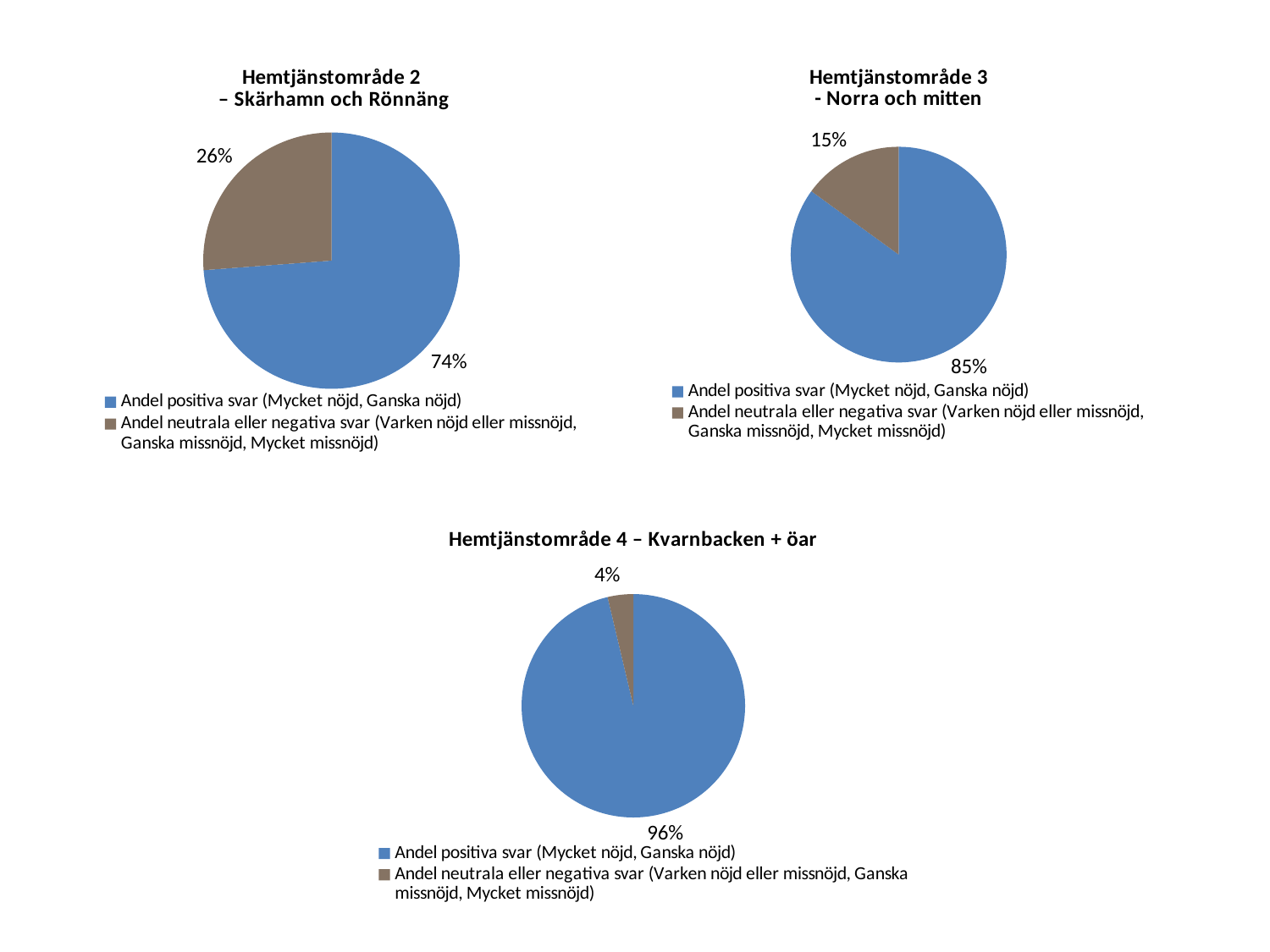
In the 'Hemtjänstområde 4 – Kvarnbacken + öar' chart, what share of responses is 'Andel neutrala eller negativa svar'? 4% What kind of chart is the 'Hemtjänstområde 4 – Kvarnbacken + öar' chart? Pie chart In the 'Hemtjänstområde 2 – Skärhamn och Rönnäng' chart, which slice is the largest? Andel positiva svar (Mycket nöjd, Ganska nöjd) Which chart has the larger share of 'Andel positiva svar': 'Hemtjänstområde 2 – Skärhamn och Rönnäng' or 'Hemtjänstområde 4 – Kvarnbacken + öar'? Hemtjänstområde 4 – Kvarnbacken + öar In the 'Hemtjänstområde 2 – Skärhamn och Rönnäng' chart, what share of responses is 'Andel neutrala eller negativa svar'? 26% In the 'Hemtjänstområde 3 - Norra och mitten' chart, what share of responses is 'Andel neutrala eller negativa svar'? 15% How many slices does the 'Hemtjänstområde 3 - Norra och mitten' pie chart have? 2 In the 'Hemtjänstområde 4 – Kvarnbacken + öar' chart, what share of responses is 'Andel positiva svar (Mycket nöjd, Ganska nöjd)'? 96% In the 'Hemtjänstområde 3 - Norra och mitten' chart, what share of responses is 'Andel positiva svar (Mycket nöjd, Ganska nöjd)'? 85% In the 'Hemtjänstområde 2 – Skärhamn och Rönnäng' chart, what is the difference in percentage points between the positive slice and the neutral/negative slice? 48 percentage points In the 'Hemtjänstområde 2 – Skärhamn och Rönnäng' chart, what share of responses is 'Andel positiva svar (Mycket nöjd, Ganska nöjd)'? 74% In the 'Hemtjänstområde 3 - Norra och mitten' chart, which slice is the smallest? Andel neutrala eller negativa svar (Varken nöjd eller missnöjd, Ganska missnöjd, Mycket missnöjd)